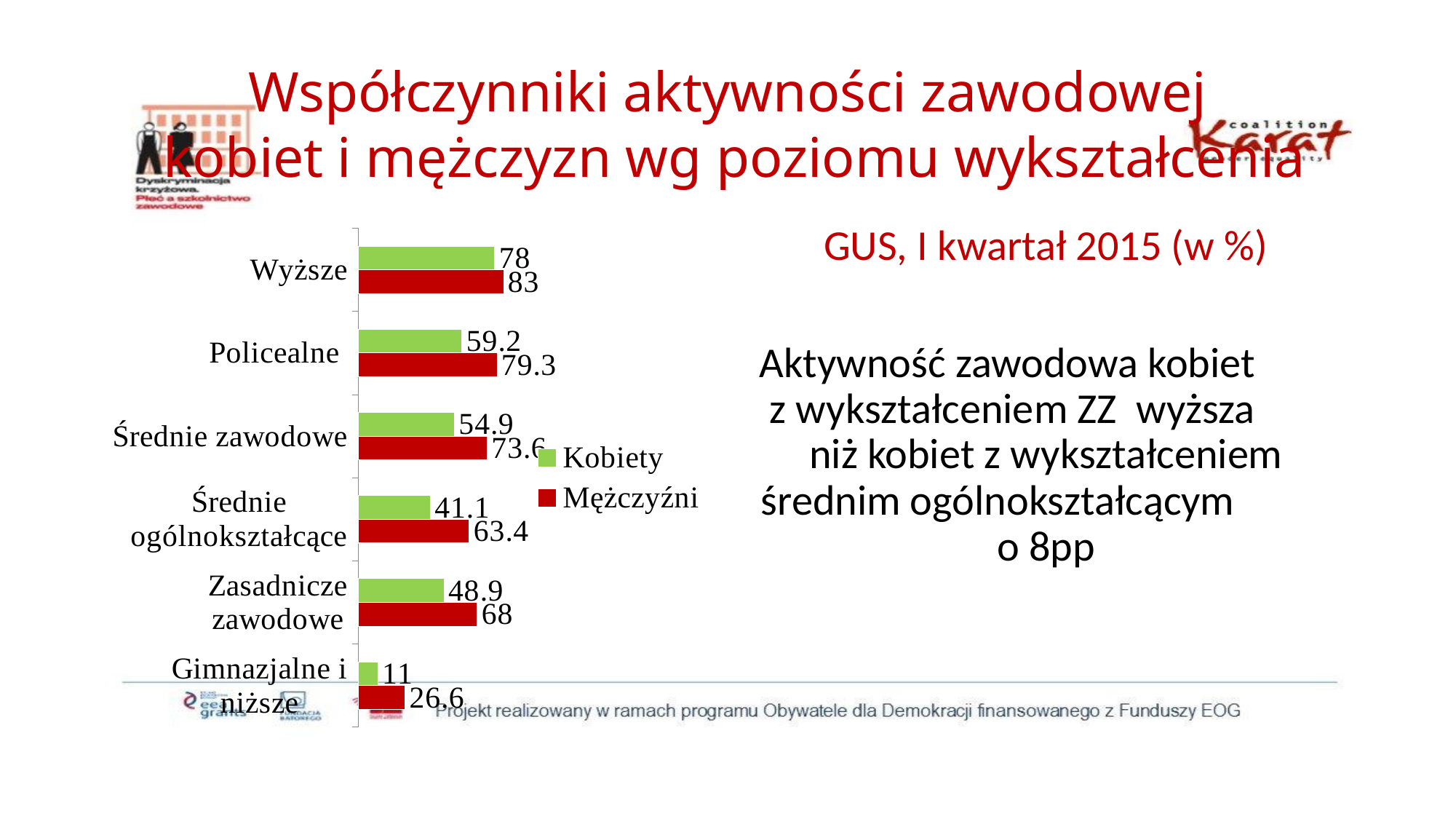
Which is larger: the Kobiety value for Zasadnicze zawodowe or the Kobiety value for Średnie ogólnokształcące? Zasadnicze zawodowe What kind of chart is shown on the slide? Bar chart How many education-level categories are shown in the chart? 6 How many series does the legend list? 2 Which category has the lowest value for Kobiety? Gimnazjalne i niższe What is the value for Kobiety in the Średnie ogólnokształcące category? 41.1 Which category has the highest value for Mężczyźni? Wyższe Which colour represents the Kobiety series in the chart? Green What is the difference between the Mężczyźni and Kobiety values in the Zasadnicze zawodowe category? 19.1 What is the value for Mężczyźni in the Policealne category? 79.3 What is the value for Kobiety in the Wyższe category? 78 What is the value for Mężczyźni in the Gimnazjalne i niższe category? 26,6